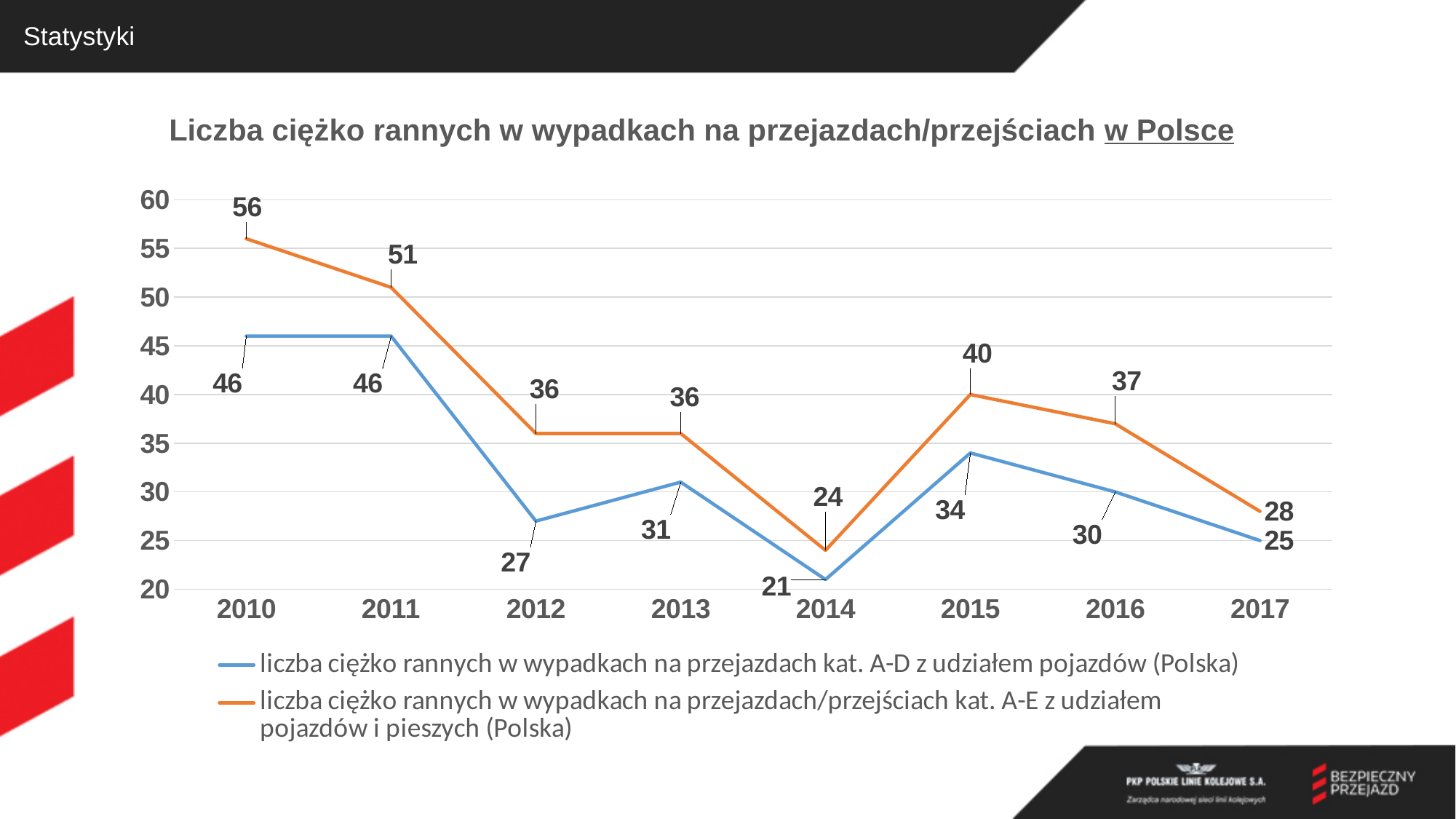
What is the value for 2010 in the series 'kat. A-E z udziałem pojazdów i pieszych'? 56 What colour is the line for the 'kat. A-D z udziałem pojazdów' series? blue How many years are shown on the x axis? 8 What is the value for 2014 in the series 'kat. A-D z udziałem pojazdów'? 21 What is the value for 2017 in the series 'kat. A-E z udziałem pojazdów i pieszych'? 28 What is the difference between the two series in 2015? 6 In which year is the 'kat. A-D z udziałem pojazdów' series at its lowest? 2014 Does the 'kat. A-E z udziałem pojazdów i pieszych' series rise or fall from 2010 to 2012? fall How many series does the legend list? 2 Which series has the higher value in 2012: 'kat. A-D' or 'kat. A-E'? kat. A-E In which year is the 'kat. A-E z udziałem pojazdów i pieszych' series at its highest? 2010 What kind of chart is shown on the slide? line chart